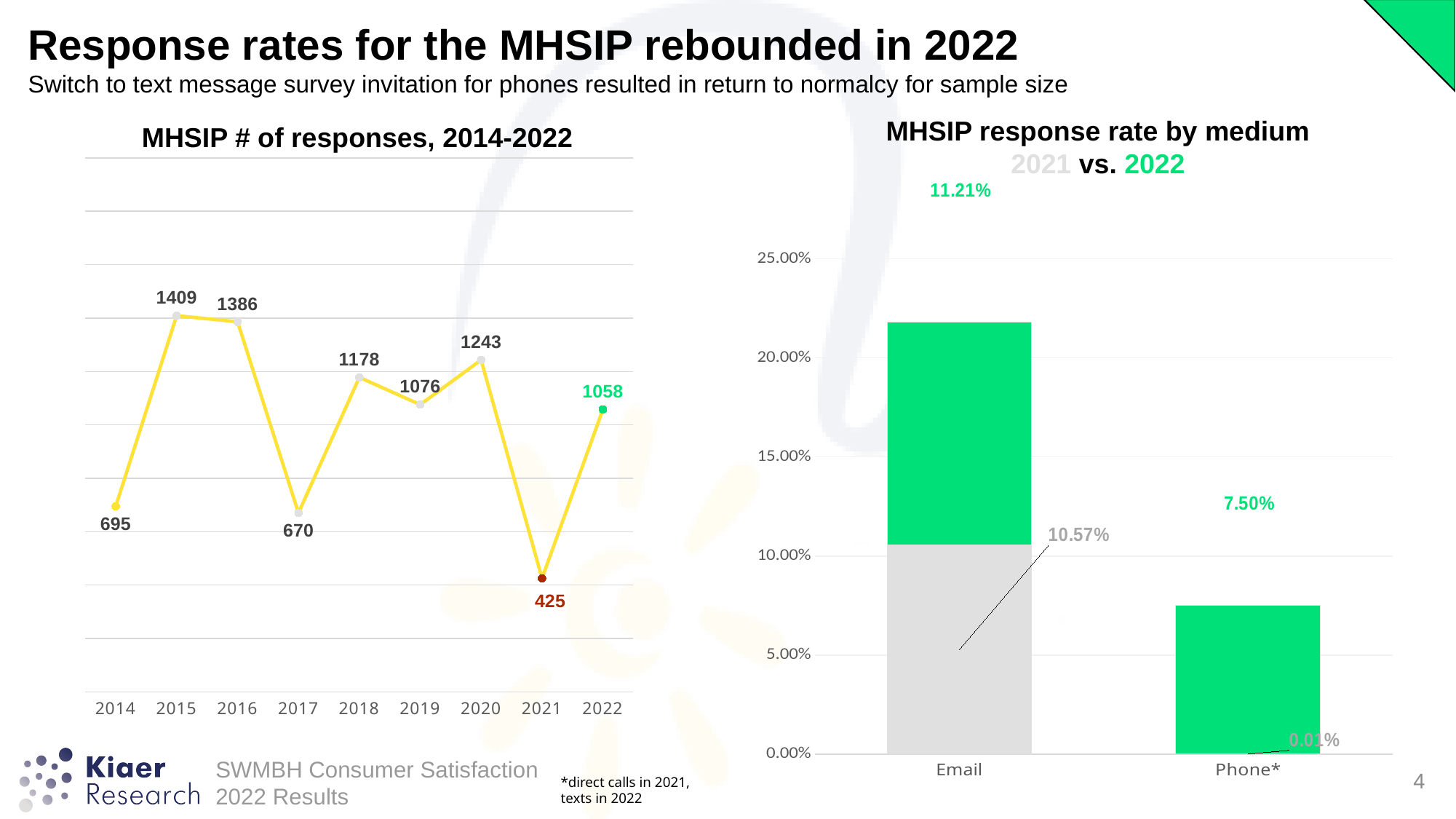
In the 'MHSIP # of responses, 2014-2022' chart, which year had the lowest number of responses? 2021 What kind of chart is 'MHSIP # of responses, 2014-2022'? Line chart In the 'MHSIP response rate by medium' chart, what was the 2021 response rate for Phone*? 0.01% In the 'MHSIP # of responses, 2014-2022' chart, by how much did the number of responses increase from 2021 to 2022? 633 In the 'MHSIP # of responses, 2014-2022' chart, how many responses were there in 2021? 425 What kind of chart is 'MHSIP response rate by medium'? Bar chart In the 'MHSIP response rate by medium' chart, which medium had the higher 2022 response rate, Email or Phone*? Email In the 'MHSIP response rate by medium' chart, what was the 2022 response rate for Email? 11.21% In the 'MHSIP # of responses, 2014-2022' chart, which year had the highest number of responses? 2015 In the 'MHSIP # of responses, 2014-2022' chart, how many years are plotted? 9 In the 'MHSIP response rate by medium' chart, what is the combined height of the Email bar (2021 plus 2022)? 21.78% In the 'MHSIP # of responses, 2014-2022' chart, did the number of responses rise or fall from 2020 to 2021? Fall